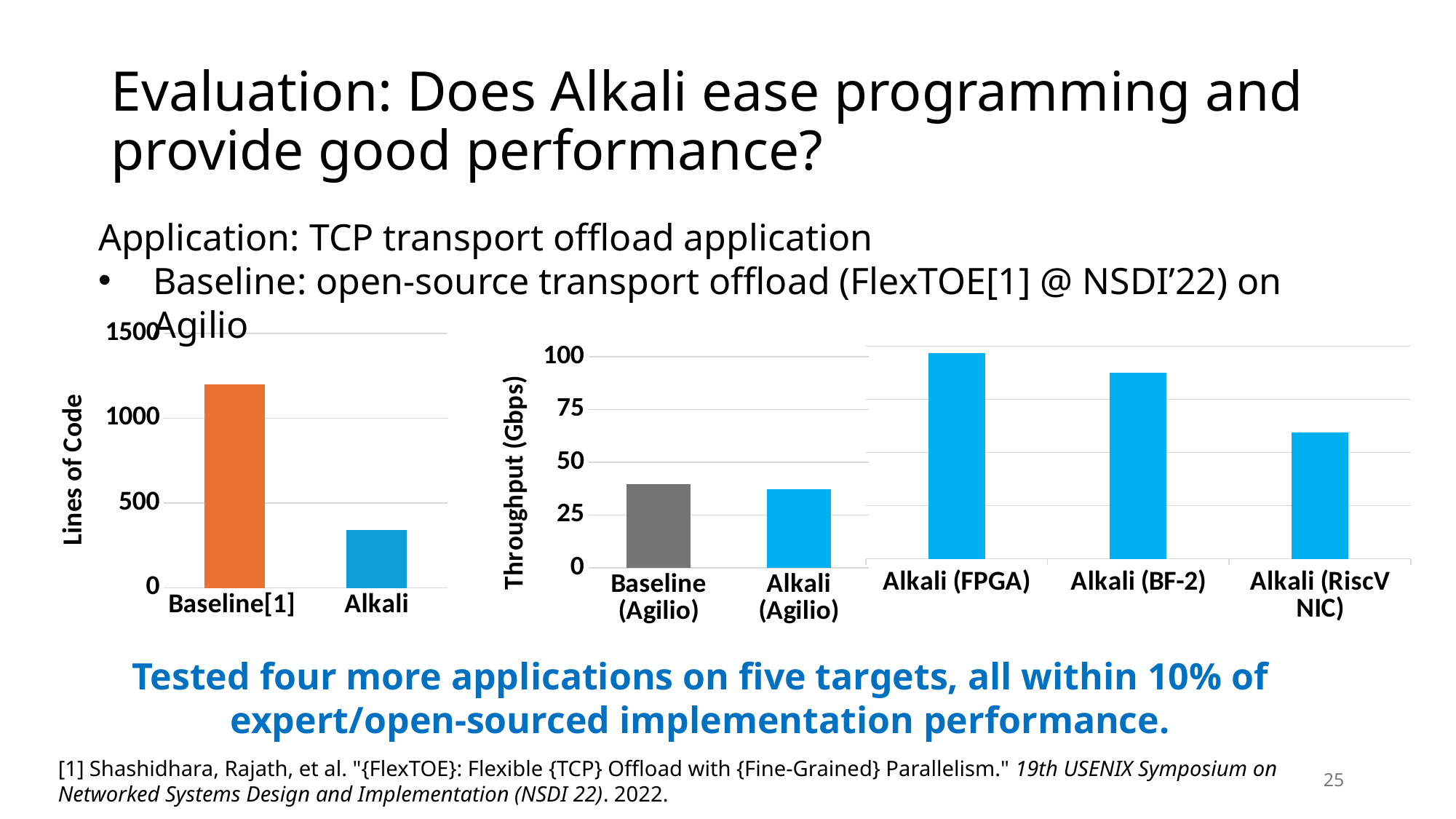
In the Lines of Code chart on the left, is the value for Alkali greater or less than 500? less In the Throughput (Gbps) chart on the right, is the value for Alkali (RiscV NIC) greater or less than 50? greater How many categories does the Lines of Code chart on the left show? 2 What is the y-axis label of the chart on the right? Throughput (Gbps) In the Throughput (Gbps) chart on the right, is the value for Alkali (BF-2) greater or less than 75? greater In the Lines of Code chart on the left, which category has the highest value? Baseline[1] What kind of chart is the Lines of Code chart on the left? bar chart What is the y-axis label of the chart on the left? Lines of Code How many categories does the Throughput (Gbps) chart on the right show? 5 In the Throughput (Gbps) chart on the right, which category has the highest value? Alkali (FPGA)